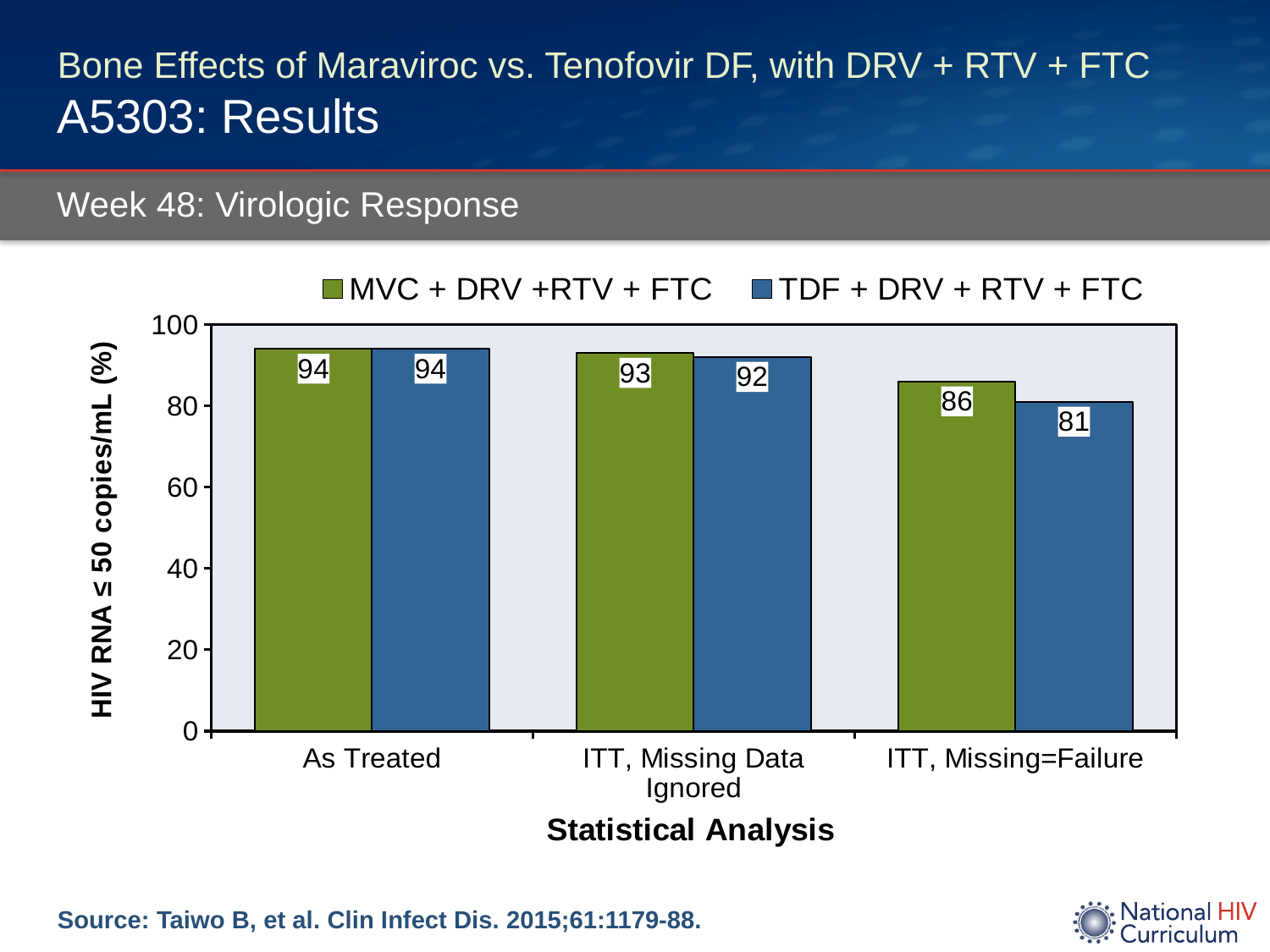
What is the difference between the MVC + DRV + RTV + FTC and TDF + DRV + RTV + FTC values in the ITT, Missing=Failure analysis? 5 Which statistical analysis has the lowest value for the TDF + DRV + RTV + FTC series? ITT, Missing=Failure What is the value for TDF + DRV + RTV + FTC in the ITT, Missing Data Ignored analysis? 92 How many series does the legend list? 2 What is the value for TDF + DRV + RTV + FTC in the ITT, Missing=Failure analysis? 81 What is the value for MVC + DRV + RTV + FTC in the As Treated analysis? 94 What kind of chart is shown on the slide? Bar chart In the ITT, Missing Data Ignored analysis, which series has the larger value? MVC + DRV + RTV + FTC What is the label of the y axis? HIV RNA ≤ 50 copies/mL (%) Is the value for TDF + DRV + RTV + FTC in the ITT, Missing=Failure analysis greater or less than 80? greater Do the values for the TDF + DRV + RTV + FTC series rise or fall across the categories from left to right? Fall How many statistical analysis categories are shown on the x axis? 3